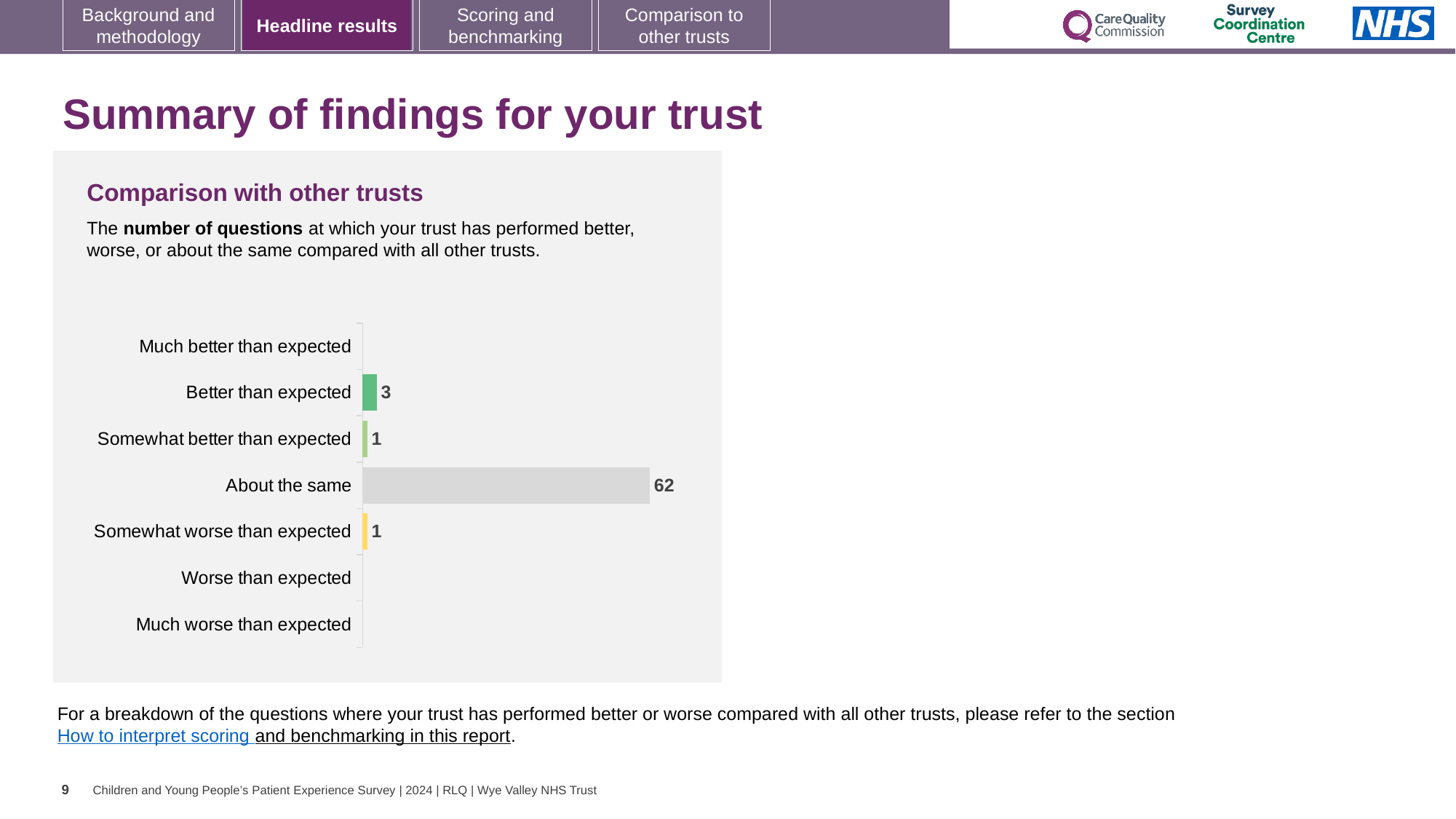
What kind of chart is shown on the slide? Bar chart What is the title of the chart? Comparison with other trusts What is the value for 'Better than expected'? 3 How many categories on the chart have a data label shown? 4 Which is larger, the value for 'Better than expected' or 'Somewhat better than expected'? Better than expected Which category has the highest number of questions? About the same What colour is the bar for 'About the same'? Grey What is the value for 'Somewhat worse than expected'? 1 How many questions are in the 'About the same' category? 62 How many categories are listed on the chart's vertical axis? 7 What is the difference between the values for 'About the same' and 'Better than expected'? 59 What is the value for 'Somewhat better than expected'? 1